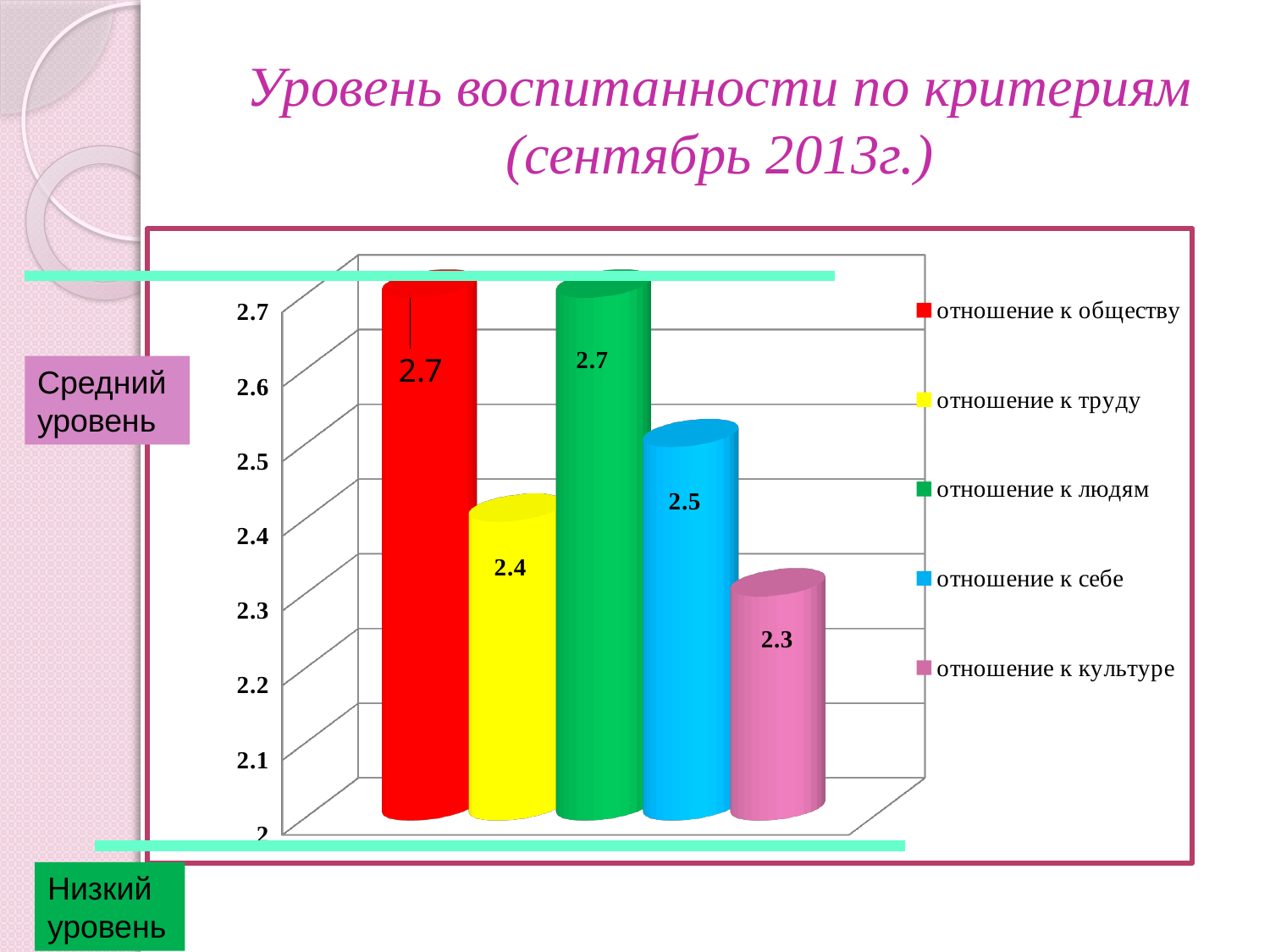
What is the value for "отношение к людям"? 2.7 What is the difference between the values for "отношение к себе" and "отношение к труду"? 0.1 What is the value for "отношение к культуре"? 2.3 What is the value for "отношение к труду"? 2.4 What is the difference between the values for "отношение к обществу" and "отношение к культуре"? 0.4 Is the value for "отношение к культуре" greater or less than 2.5? less Which is larger, the value for "отношение к себе" or the value for "отношение к труду"? отношение к себе What colour is the bar for "отношение к людям"? green What is the value for "отношение к себе"? 2.5 What kind of chart is shown on the slide? bar chart Which criterion has the lowest value? отношение к культуре How many series does the legend list? 5